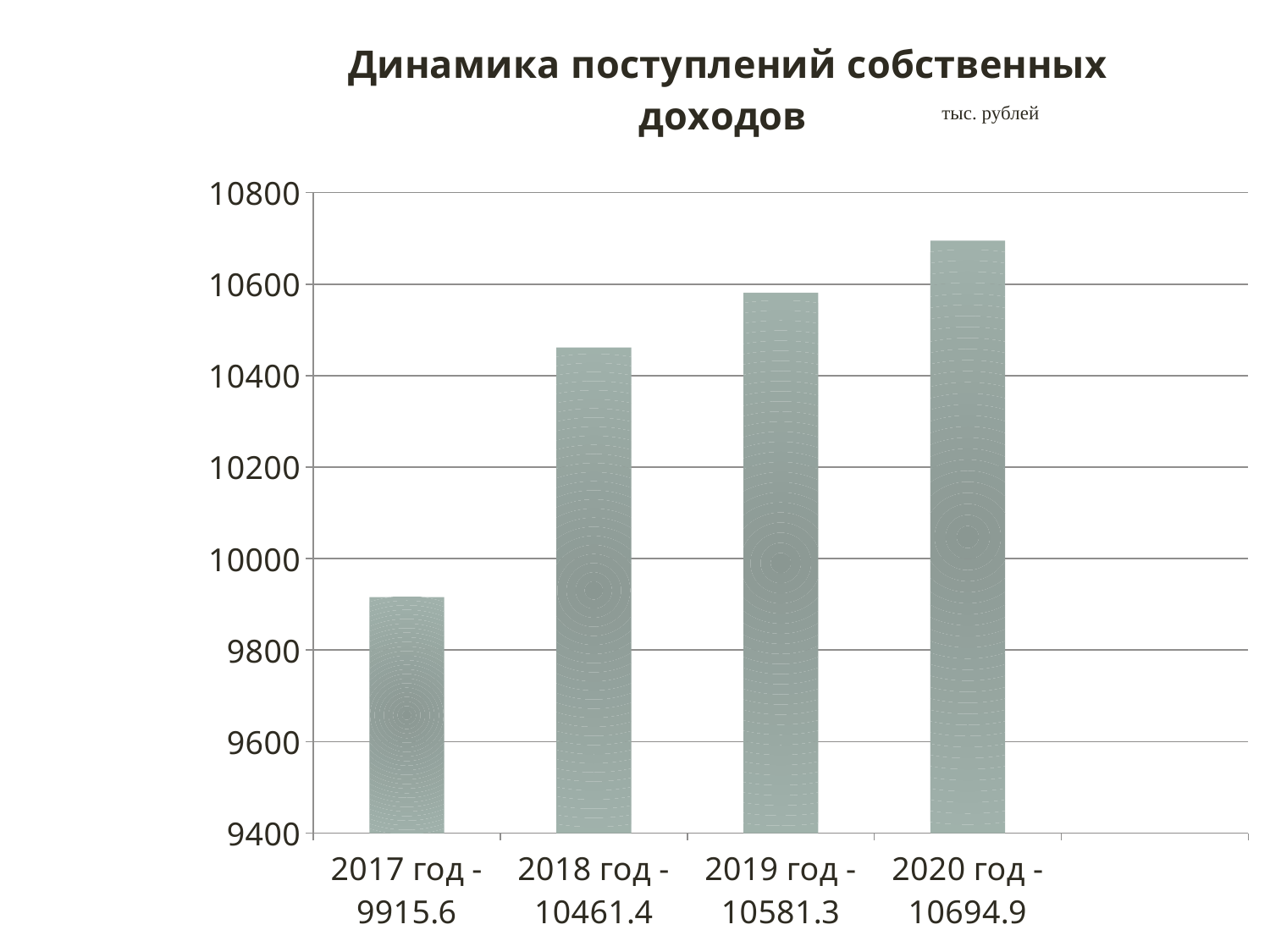
Do the values rise or fall from 2017 год to 2020 год? Rise What type of chart is shown on the slide? Bar chart What is the title of the chart? Динамика поступлений собственных доходов What is the value for 2020 год? 10694.9 What is the value for 2018 год? 10461.4 What is the value for 2017 год? 9915.6 Which year has the lowest value? 2017 год What unit is indicated for the values on the chart? тыс. рублей How many bars (years) are shown on the chart? 4 Which year has the highest value? 2020 год What is the difference between the values for 2018 год and 2017 год? 545.8 Which is larger, the value for 2019 год or the value for 2018 год? 2019 год